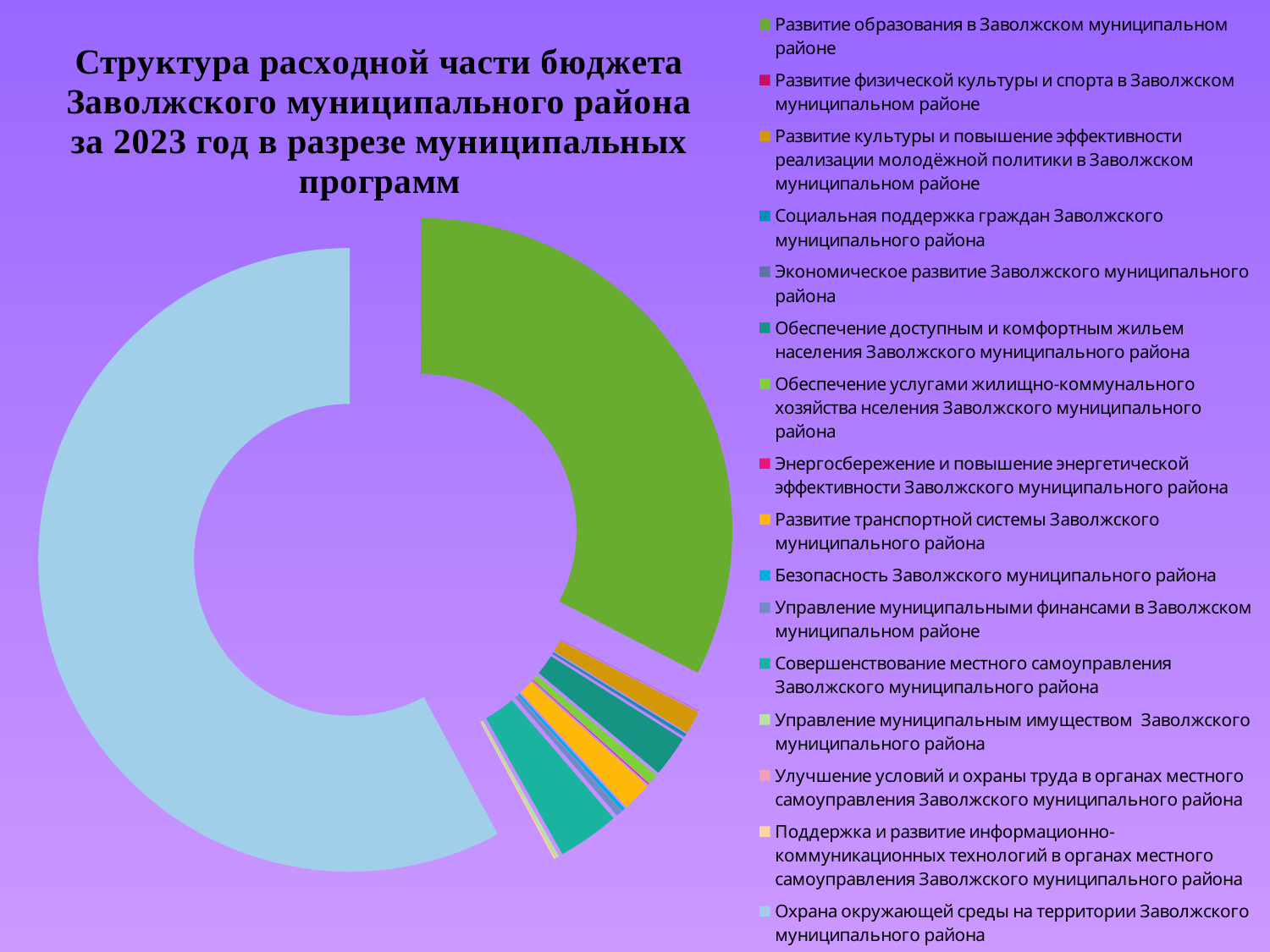
What colour is the slice for Развитие образования в Заволжском муниципальном районе? Green Which category is the second-largest slice in the chart? Развитие образования в Заволжском муниципальном районе What is the title of the chart on the slide? Структура расходной части бюджета Заволжского муниципального района за 2023 год в разрезе муниципальных программ Which year does the chart's title say the budget structure refers to? 2023 Which slice is larger: the light blue one (Охрана окружающей среды) or the green one (Развитие образования в Заволжском муниципальном районе)? Охрана окружающей среды (light blue) Which slice is larger: Развитие образования в Заволжском муниципальном районе or Социальная поддержка граждан Заволжского муниципального района? Развитие образования в Заволжском муниципальном районе Which category has the largest slice in the chart? Охрана окружающей среды на территории Заволжского муниципального района How many categories does the legend of the chart list? 16 What kind of chart is shown on the slide? Doughnut (pie) chart